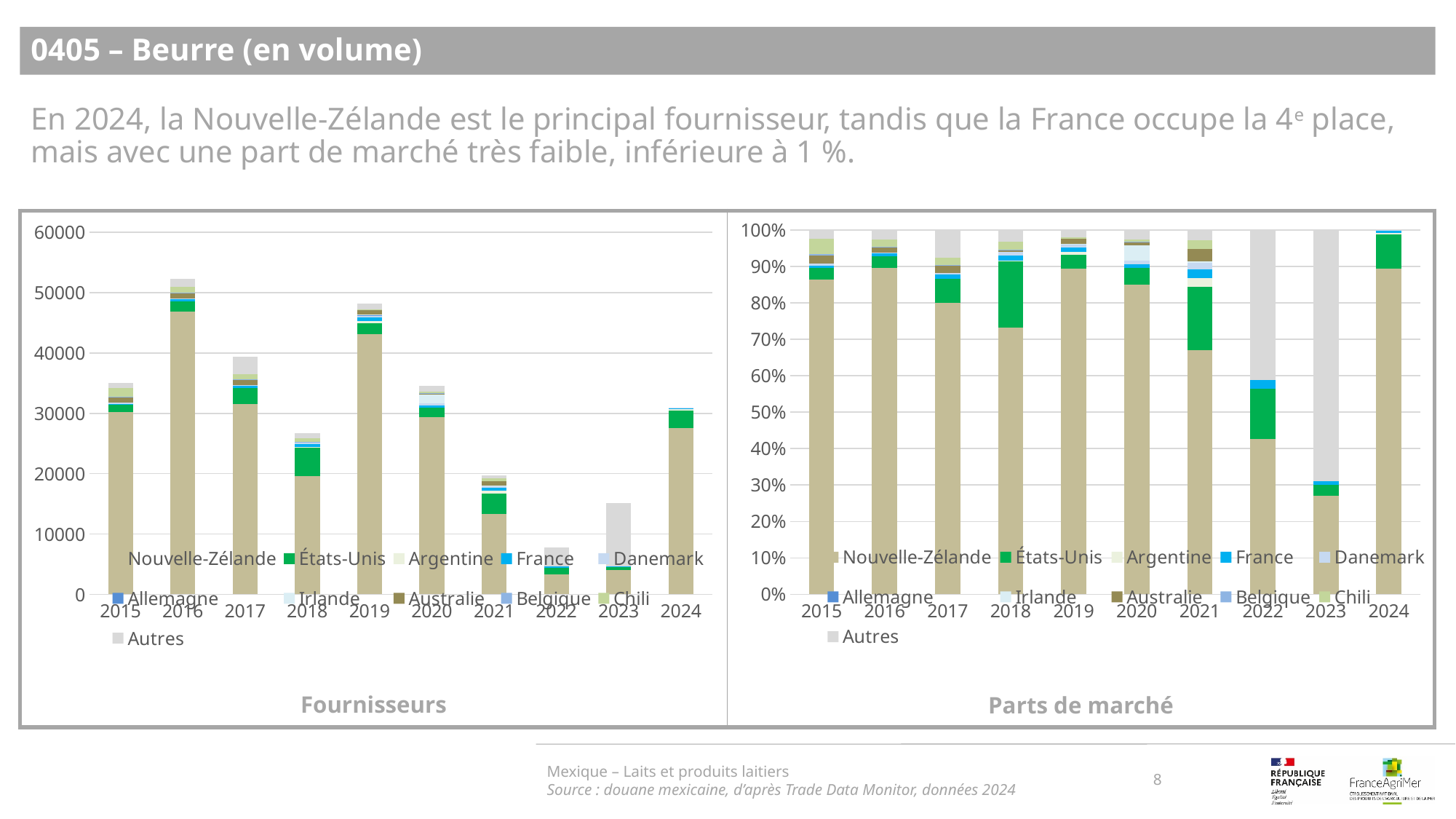
In the 'Fournisseurs' chart, is the total bar for 2017 taller than the total bar for 2018? Yes What kind of chart is the 'Fournisseurs' chart? bar chart In the 'Fournisseurs' chart, which year has the highest total bar? 2016 In the 'Fournisseurs' chart, which year has the lowest total bar? 2022 In the 'Parts de marché' chart, is the share of Nouvelle-Zélande in 2023 greater or less than 40%? less In the 'Fournisseurs' chart, is the total for 2016 greater or less than 50000? greater In the 'Parts de marché' chart, is the share of Nouvelle-Zélande in 2024 greater or less than 80%? greater How many series does the legend of the 'Parts de marché' chart list? 11 Which series is shown in light grey in the legend of the 'Fournisseurs' chart? Autres In the 'Parts de marché' chart, which year has the largest 'Autres' segment? 2023 How many years are shown on the x axis of the 'Fournisseurs' chart? 10